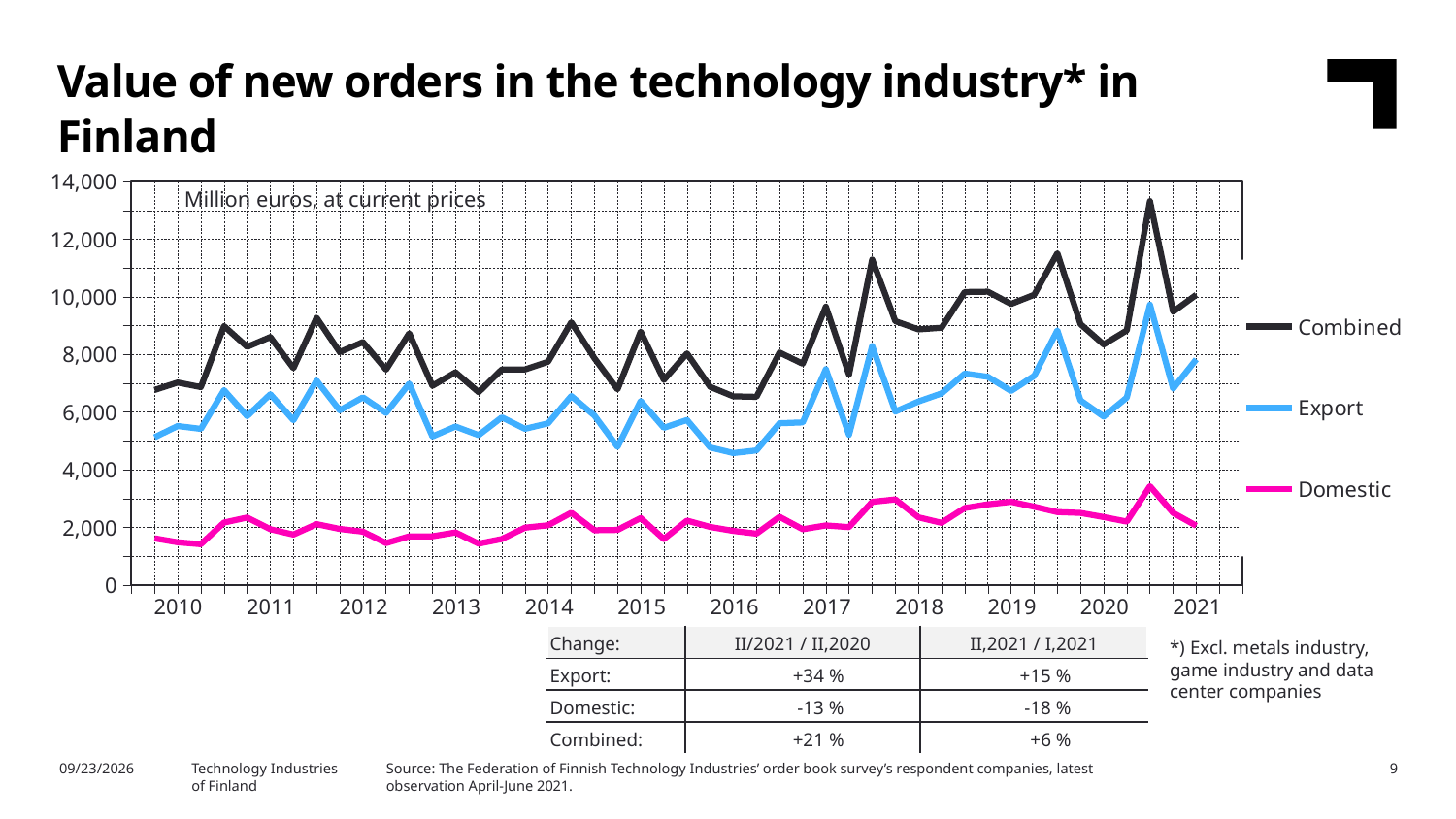
Does the Combined series overall rise or fall from 2010 to 2021? rise How many years are labelled on the x axis? 12 Is the peak value of the Export series in 2020 greater or less than 10,000? less Which series has the highest values throughout the chart? Combined How many series does the chart legend list? 3 Is the Domestic series ever greater or less than 4,000 across the whole chart? less Which series has the lowest values throughout the chart? Domestic Which series is larger in 2021, Export or Domestic? Export Is the peak value of the Combined series in 2020 greater or less than 12,000? greater What kind of chart is shown on the slide? Line chart What colour is the Export line in the chart? Blue What unit is stated in the chart's subtitle? Million euros, at current prices